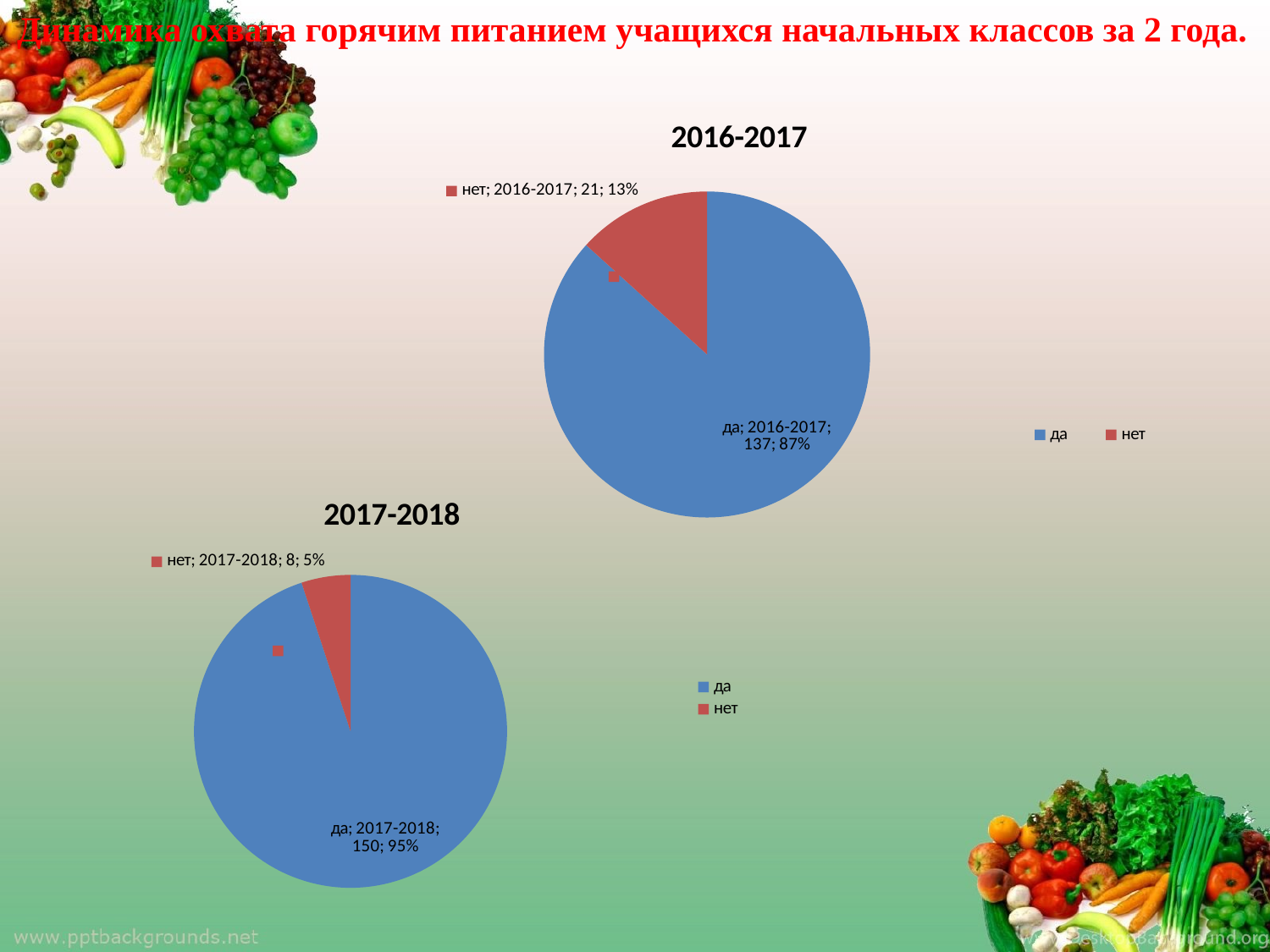
In the 2016-2017 chart, which category is the largest? да In the 2017-2018 chart, which category is the smallest? нет What type of chart is the 2017-2018 chart? pie chart In the 2017-2018 chart, what value is shown for "нет"? 8 In the 2016-2017 chart, what percentage share does "нет" have? 13% Which is larger: the value for "нет" in the 2016-2017 chart or the value for "нет" in the 2017-2018 chart? 2016-2017 In the 2016-2017 chart, what is the difference between the values for "да" and "нет"? 116 In the 2017-2018 chart, what percentage share does "да" have? 95% In the 2016-2017 chart, what value is shown for "да"? 137 How many categories does the 2016-2017 chart have? 2 What colour represents "нет" in the 2017-2018 chart? red What is the total of the two values in the 2017-2018 chart? 158